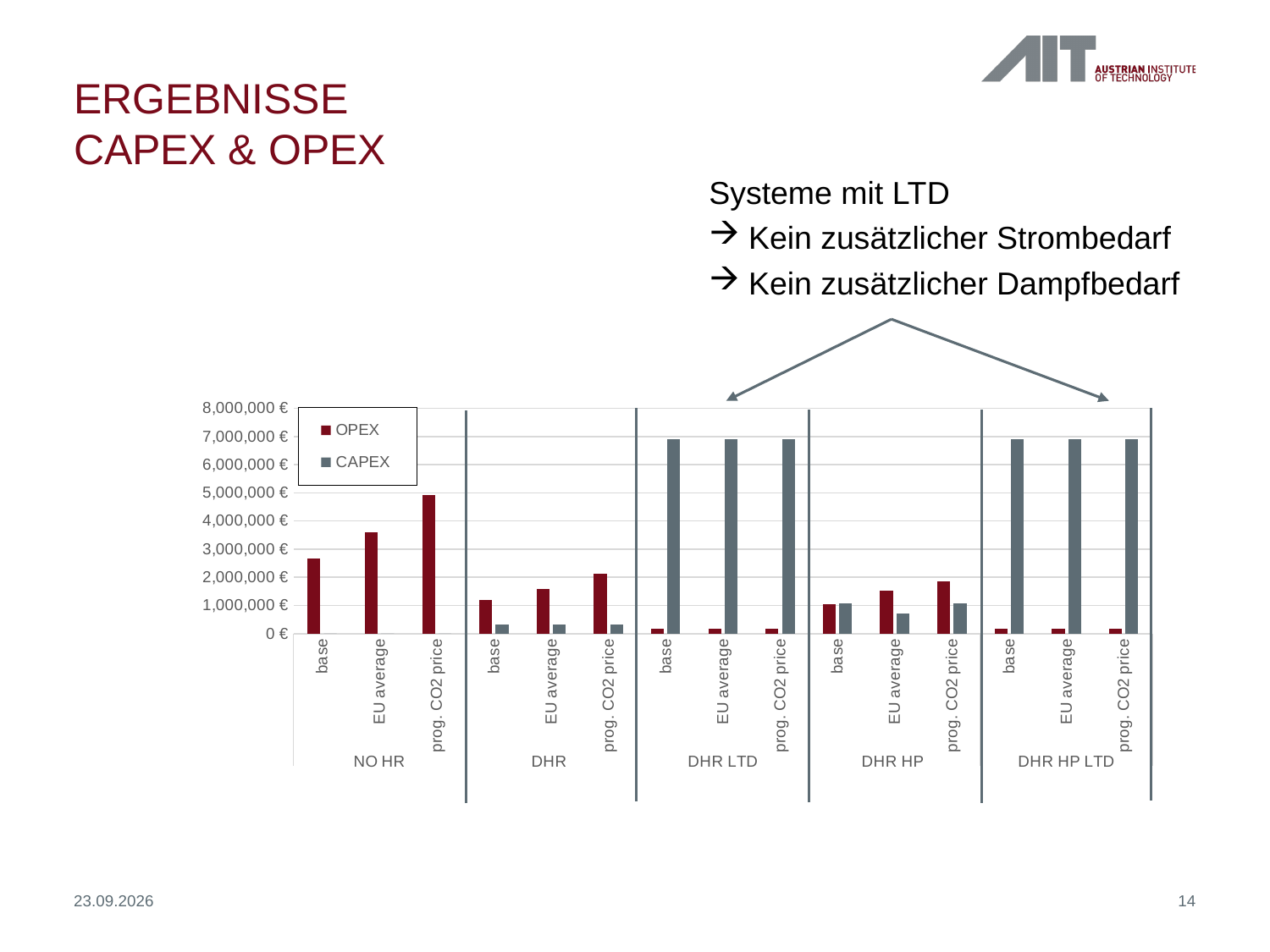
What kind of chart is shown on the slide? bar chart Which bar has the highest OPEX value in the chart? prog. CO2 price in NO HR How many system groups (NO HR, DHR, etc.) are shown along the x axis of the chart? 5 How many series does the chart legend list? 2 Is the OPEX value for base in the NO HR group greater or less than 3,000,000 €? less What are the two series named in the chart legend? OPEX and CAPEX Is the OPEX value for prog. CO2 price in the DHR HP group greater or less than 1,000,000 €? greater Which is larger: the OPEX for EU average in the NO HR group or the OPEX for EU average in the DHR group? NO HR EU average Is the OPEX value for prog. CO2 price in the NO HR group greater or less than 4,000,000 €? greater How many price cases (base, EU average, prog. CO2 price) are shown within each system group? 3 In the DHR HP group, which is larger for EU average: OPEX or CAPEX? OPEX